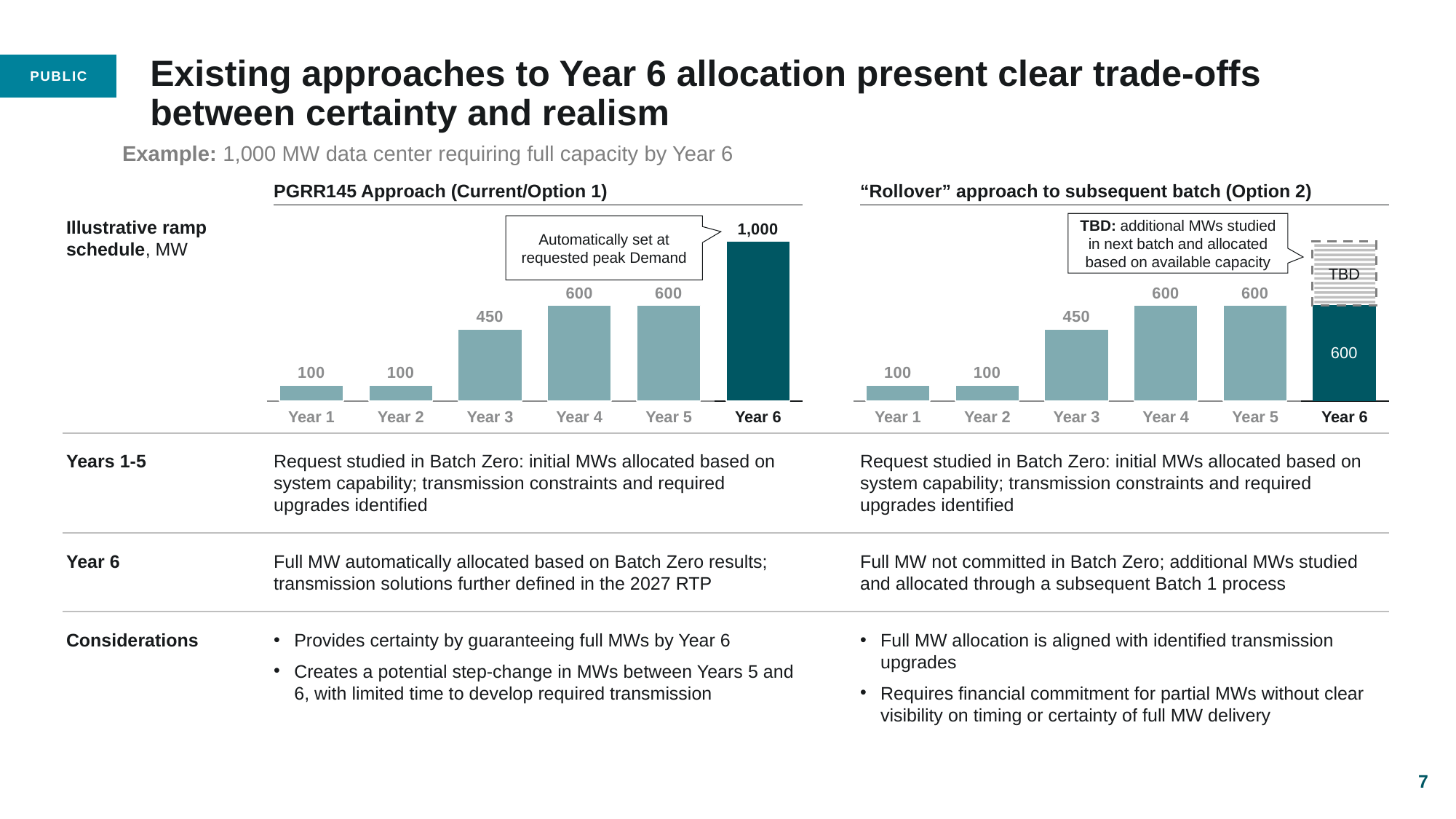
In the PGRR145 Approach (Current/Option 1) chart, do the values generally rise or fall from Year 1 to Year 6? Rise In the PGRR145 Approach (Current/Option 1) chart, what is the value for Year 6? 1,000 What unit is the illustrative ramp schedule measured in, according to the row label on the left of the charts? MW In the "Rollover" approach to subsequent batch (Option 2) chart, what is the committed value shown inside the Year 6 bar? 600 In the "Rollover" approach to subsequent batch (Option 2) chart, what is the difference between the Year 3 and Year 2 values? 350 In the PGRR145 Approach (Current/Option 1) chart, which year has the highest value? Year 6 How many years are shown on the x axis of the PGRR145 Approach (Current/Option 1) chart? 6 In the PGRR145 Approach (Current/Option 1) chart, what is the difference between the Year 6 and Year 5 values? 400 In the PGRR145 Approach (Current/Option 1) chart, what is the value for Year 3? 450 In the "Rollover" approach to subsequent batch (Option 2) chart, what label is shown on the dashed segment above the Year 6 bar? TBD What kind of chart is the "Rollover" approach to subsequent batch (Option 2) chart? Bar chart In the PGRR145 Approach (Current/Option 1) chart, which is larger, the value for Year 4 or the value for Year 3? Year 4